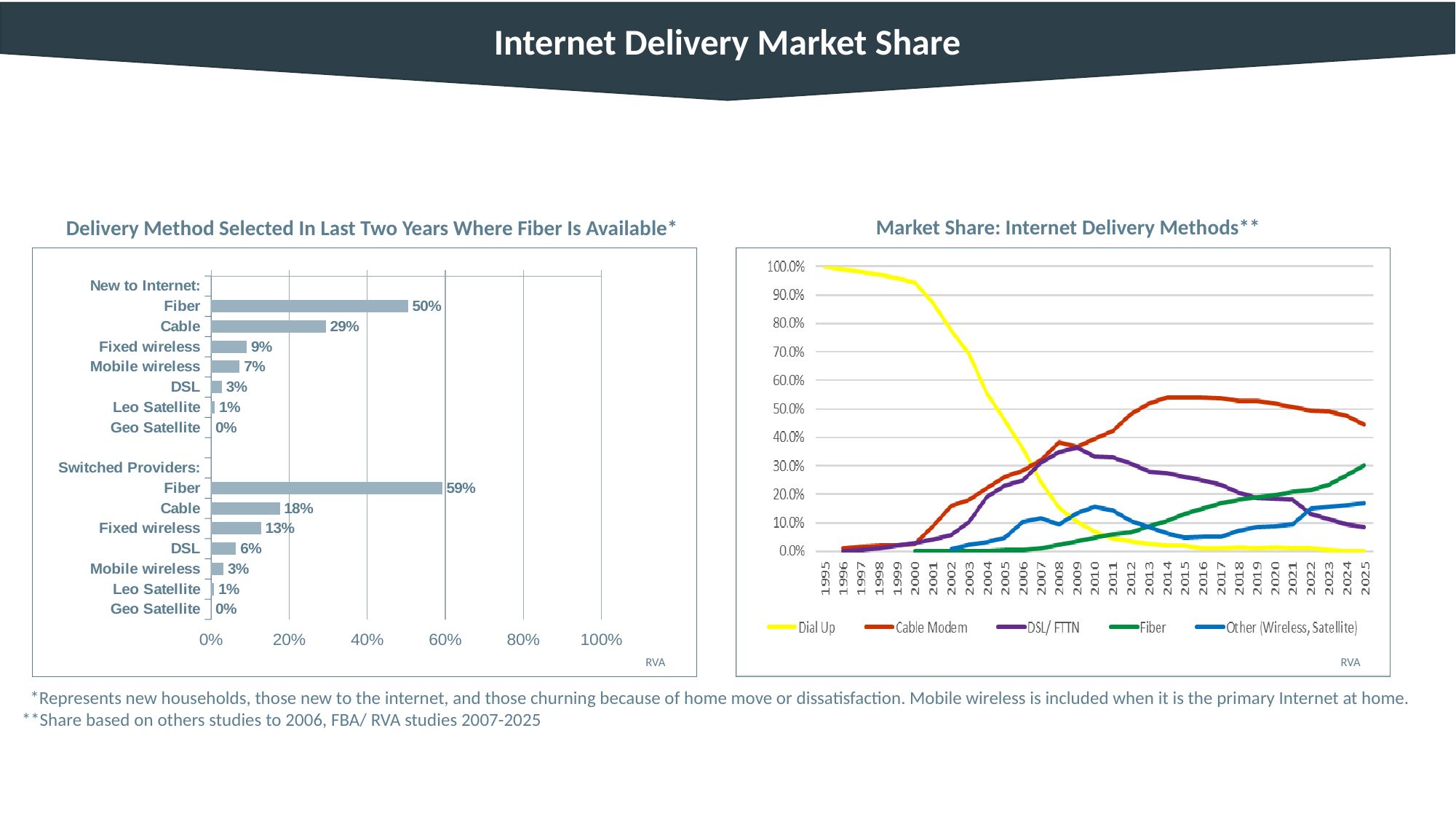
In the 'Delivery Method Selected In Last Two Years Where Fiber Is Available' chart, which is larger for those new to the internet: Fixed wireless or Mobile wireless? Fixed wireless How many series does the legend of the 'Market Share: Internet Delivery Methods' chart list? 5 In the 'Delivery Method Selected In Last Two Years Where Fiber Is Available' chart, what percentage of those new to the internet selected Fiber? 50% In the 'Delivery Method Selected In Last Two Years Where Fiber Is Available' chart, which delivery method has the highest share among switched providers? Fiber In the 'Market Share: Internet Delivery Methods' chart, does the Dial Up line rise or fall from 2000 to 2010? Fall In the 'Delivery Method Selected In Last Two Years Where Fiber Is Available' chart, what is the difference between Cable for new to internet and Cable for switched providers? 11% In the 'Market Share: Internet Delivery Methods' chart, is the Cable Modem value in 2015 greater or less than 50.0%? greater In the 'Market Share: Internet Delivery Methods' chart, which series has the highest value in 2025? Cable Modem In the 'Delivery Method Selected In Last Two Years Where Fiber Is Available' chart, what is the difference between the Fiber share for switched providers and the Fiber share for those new to the internet? 9% What kind of chart is 'Delivery Method Selected In Last Two Years Where Fiber Is Available'? Bar chart In the 'Delivery Method Selected In Last Two Years Where Fiber Is Available' chart, what percentage of switched providers selected Cable? 18% In the 'Market Share: Internet Delivery Methods' chart, which colour represents Fiber? Green